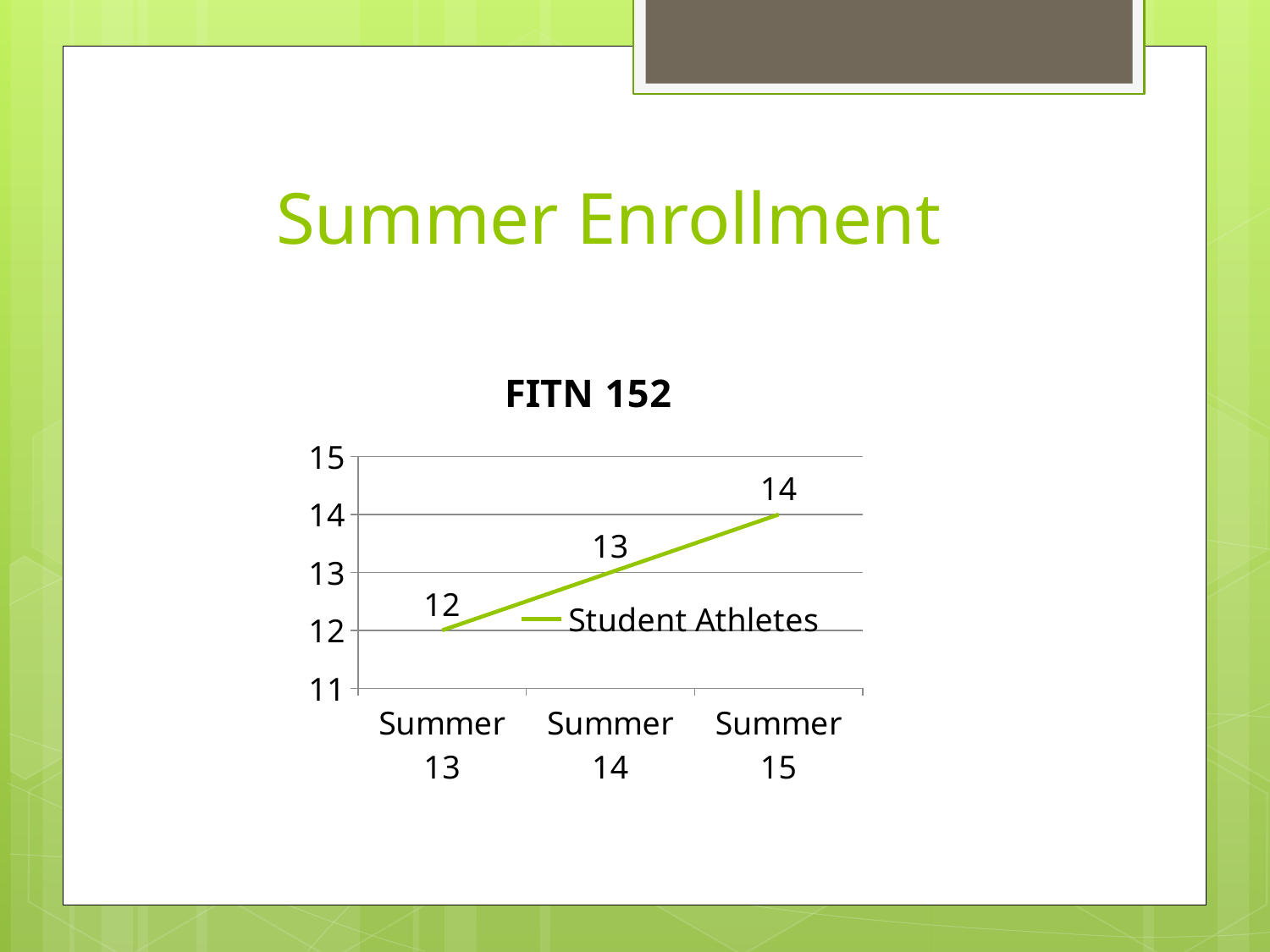
How many data points are plotted on the chart? 3 Which summer has the lowest value? Summer 13 What is the value for Summer 14? 13 What is the title of the chart? FITN 152 How many series does the legend list? 1 Do the values rise or fall from Summer 13 to Summer 15? rise Which is larger, the value for Summer 14 or Summer 13? Summer 14 What kind of chart is shown? line chart What is the difference between the values for Summer 15 and Summer 13? 2 What is the value for Summer 15? 14 What is the value for Summer 13? 12 Which summer has the highest value? Summer 15